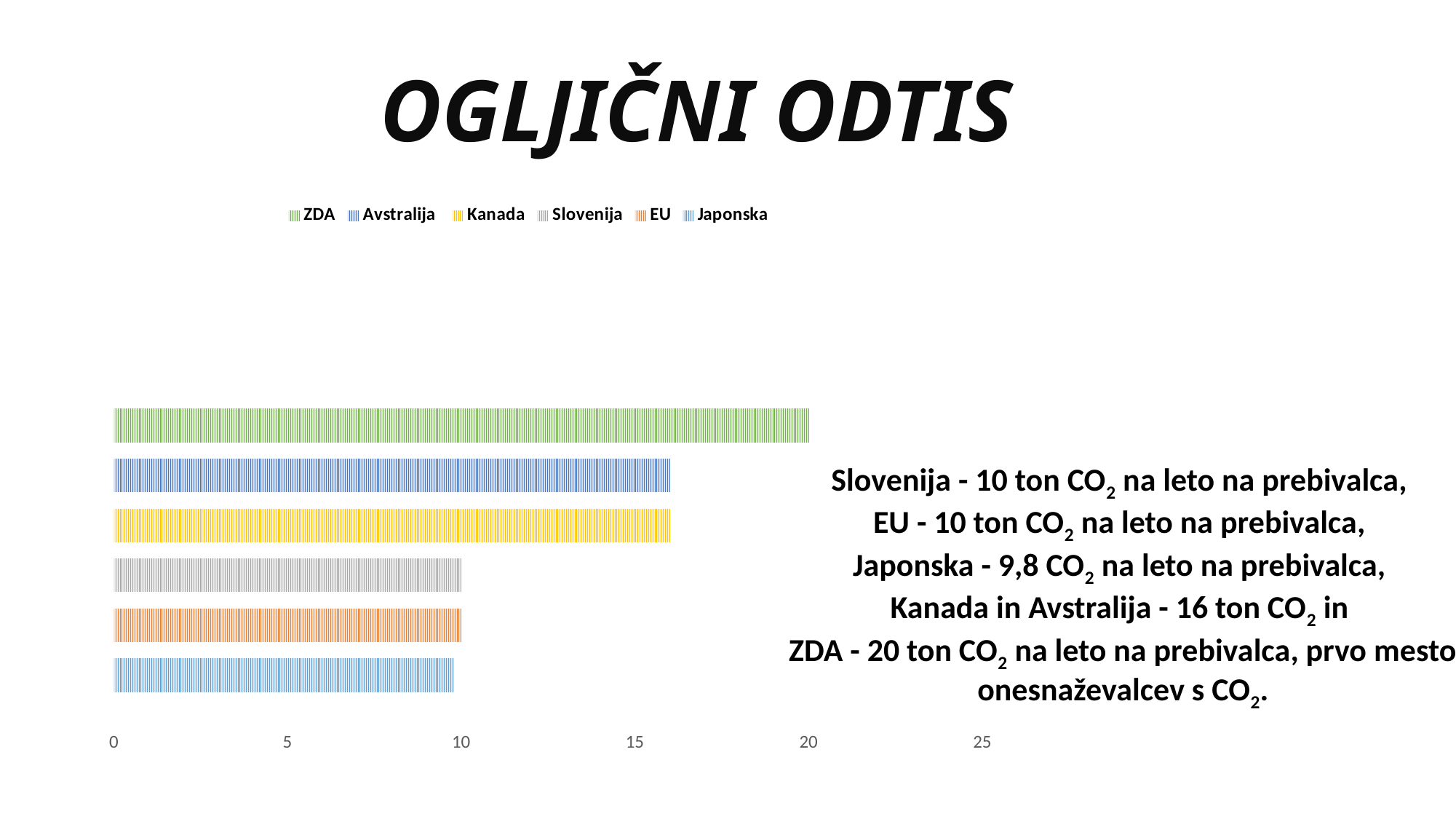
How many bars are plotted in the chart? 6 What is the value of the ZDA bar? 20 Which series has the longest bar in the chart? ZDA What is the value of the Slovenija bar? 10 What is the title of the slide containing the chart? OGLJIČNI ODTIS What is the difference between the ZDA value and the EU value? 10 What is the value of the EU bar? 10 Which is larger, the value for ZDA or the value for Slovenija? ZDA What type of chart is shown on the slide? bar chart Is the value for Avstralija greater or less than 15? greater Is the value for Japonska greater or less than 15? less How many series does the chart legend list? 6